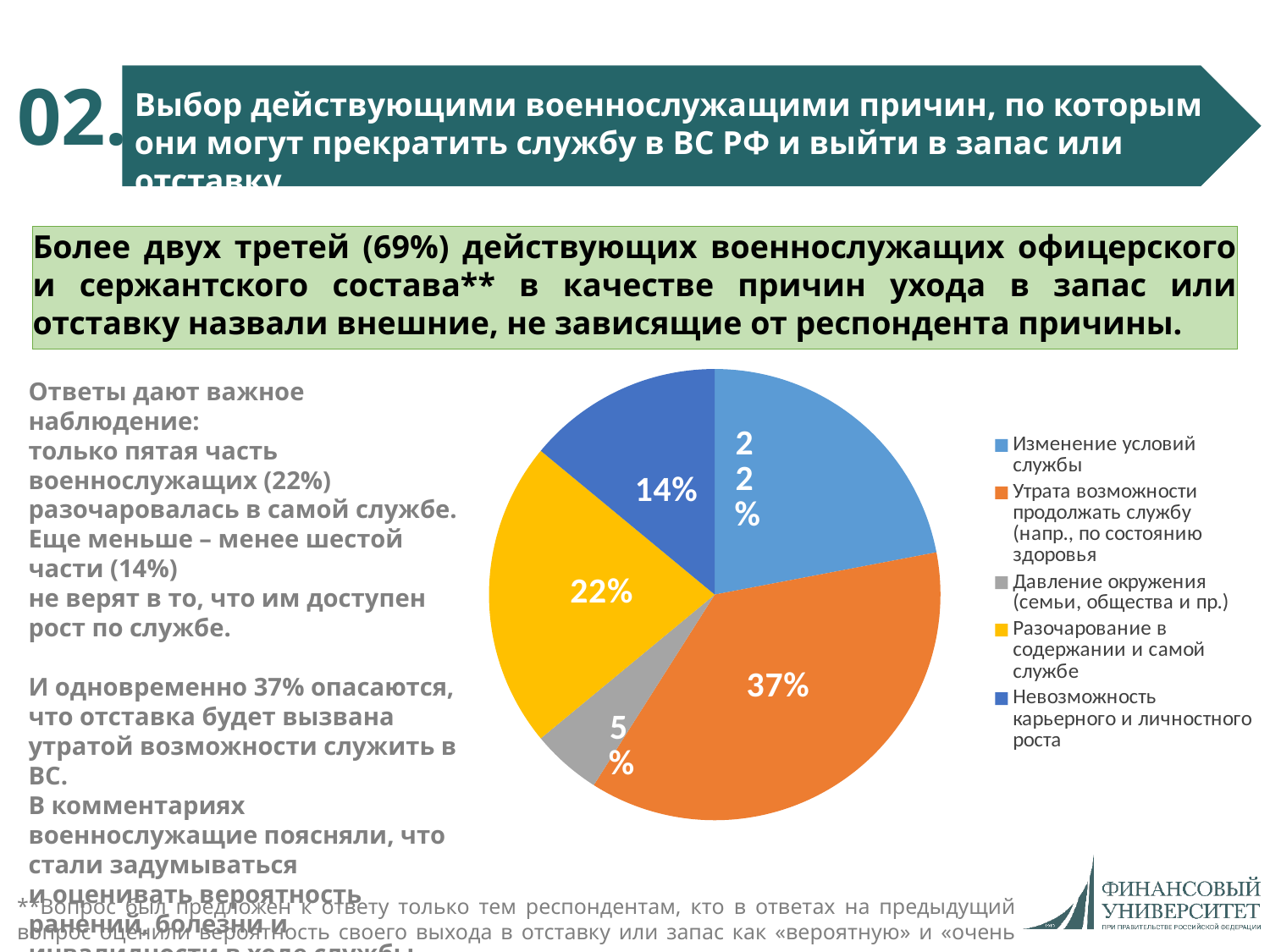
What colour is the slice for 'Разочарование в содержании и самой службе'? yellow What is the difference in percentage points between the 'Утрата возможности продолжать службу' slice and the 'Давление окружения' slice? 32 How many slices does the pie chart have? 5 What type of chart is shown on the slide? pie chart What share of the pie is labelled for 'Утрата возможности продолжать службу (напр., по состоянию здоровья)'? 37% Which slice is larger: 'Невозможность карьерного и личностного роста' or 'Утрата возможности продолжать службу'? Утрата возможности продолжать службу What share of the pie is labelled for 'Давление окружения (семьи, общества и пр.)'? 5% Which category has the largest slice of the pie? Утрата возможности продолжать службу (напр., по состоянию здоровья) How many entries does the legend of the pie chart list? 5 What share of the pie is labelled for 'Разочарование в содержании и самой службе'? 22% Which category has the smallest slice of the pie? Давление окружения (семьи, общества и пр.) What share of the pie is labelled for 'Невозможность карьерного и личностного роста'? 14%